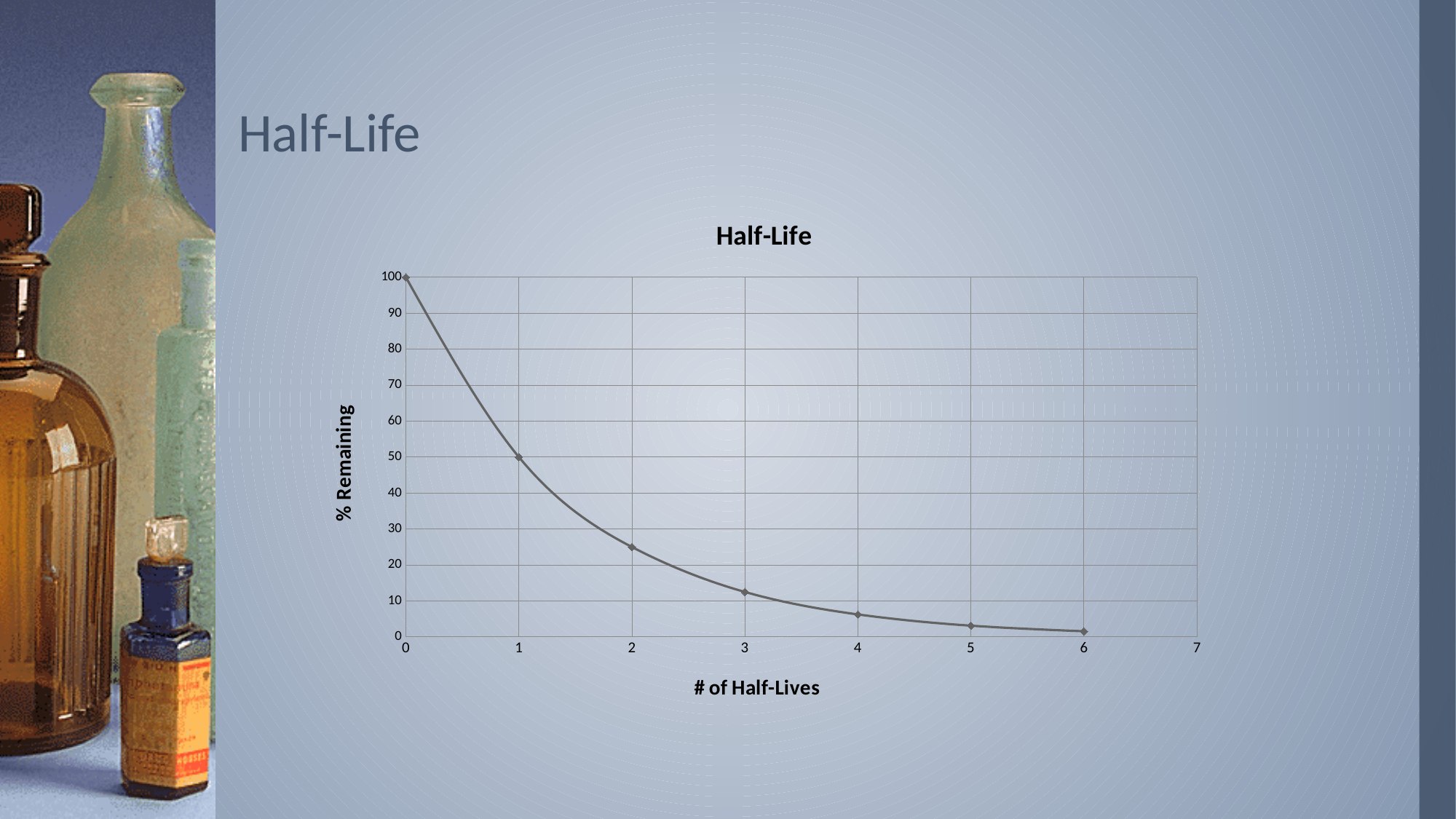
Is the % Remaining at 3 half-lives greater or less than 20? less Which has a larger % Remaining: 2 half-lives or 4 half-lives? 2 half-lives What kind of chart is shown on the slide? Line chart Is the % Remaining at 4 half-lives greater or less than 10? less How many data points are plotted on the chart? 7 What is the % Remaining at 0 half-lives? 100 At which number of half-lives is the % Remaining highest? 0 Does the % Remaining rise or fall as the number of half-lives increases? Fall What is the difference in % Remaining between 0 half-lives and 1 half-life? 50 At which number of half-lives is the % Remaining lowest? 6 What is the % Remaining at 1 half-life? 50 Is the % Remaining at 2 half-lives greater or less than 20? greater